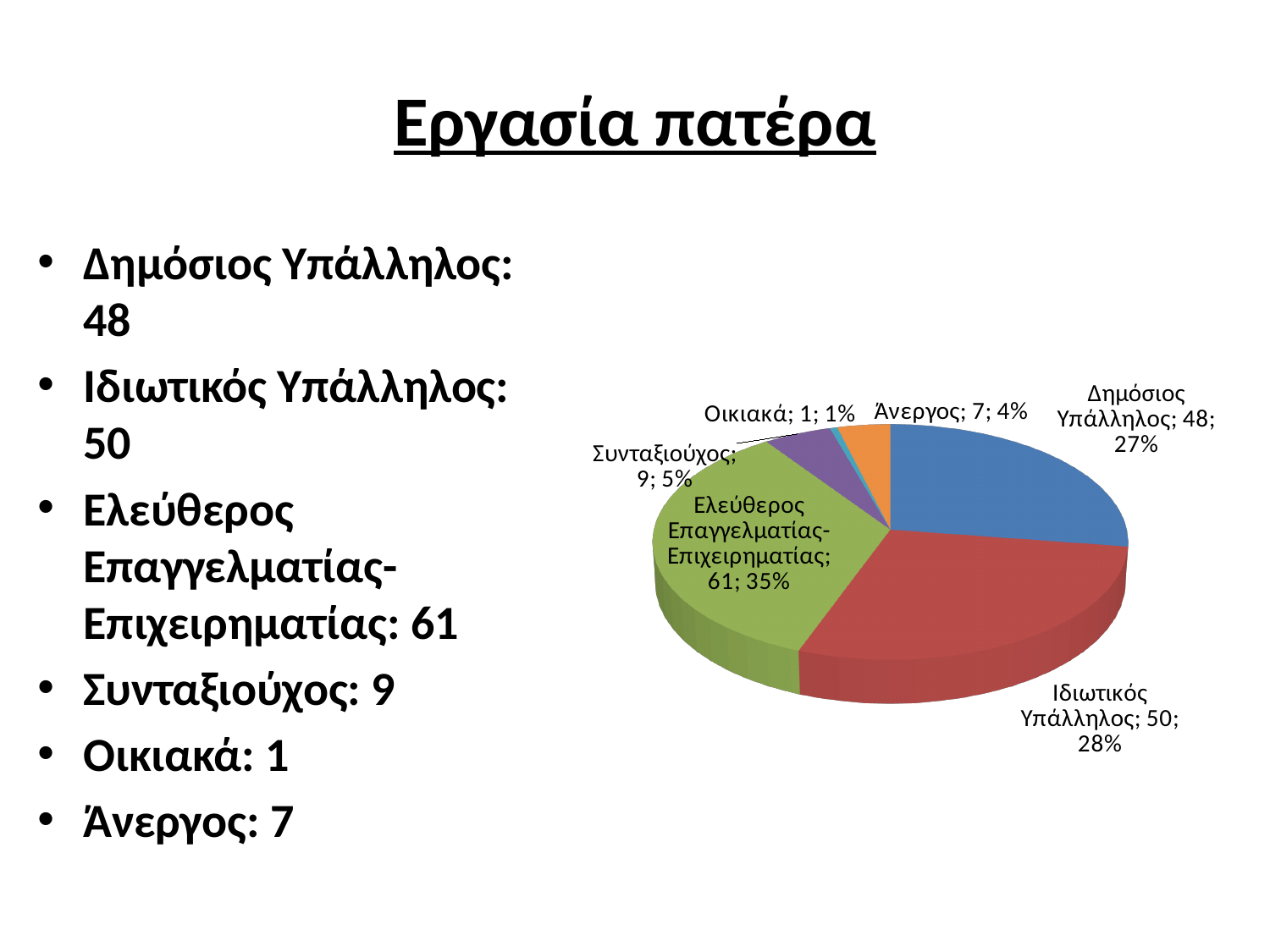
What is the title of the slide containing the pie chart? Εργασία πατέρα What is the difference between the values for Ελεύθερος Επαγγελματίας-Επιχειρηματίας and Δημόσιος Υπάλληλος? 13 What is the value for Ιδιωτικός Υπάλληλος in the pie chart? 50 How many slices does the pie chart have? 6 What percentage share does Ελεύθερος Επαγγελματίας-Επιχειρηματίας have in the pie chart? 35% Which category has the smallest slice in the pie chart? Οικιακά What is the value for Συνταξιούχος in the pie chart? 9 What percentage share does Άνεργος have in the pie chart? 4% Which category has the largest slice in the pie chart? Ελεύθερος Επαγγελματίας-Επιχειρηματίας What kind of chart is shown on the slide? pie chart Which is larger, the value for Συνταξιούχος or the value for Άνεργος? Συνταξιούχος What is the value for Δημόσιος Υπάλληλος in the pie chart? 48